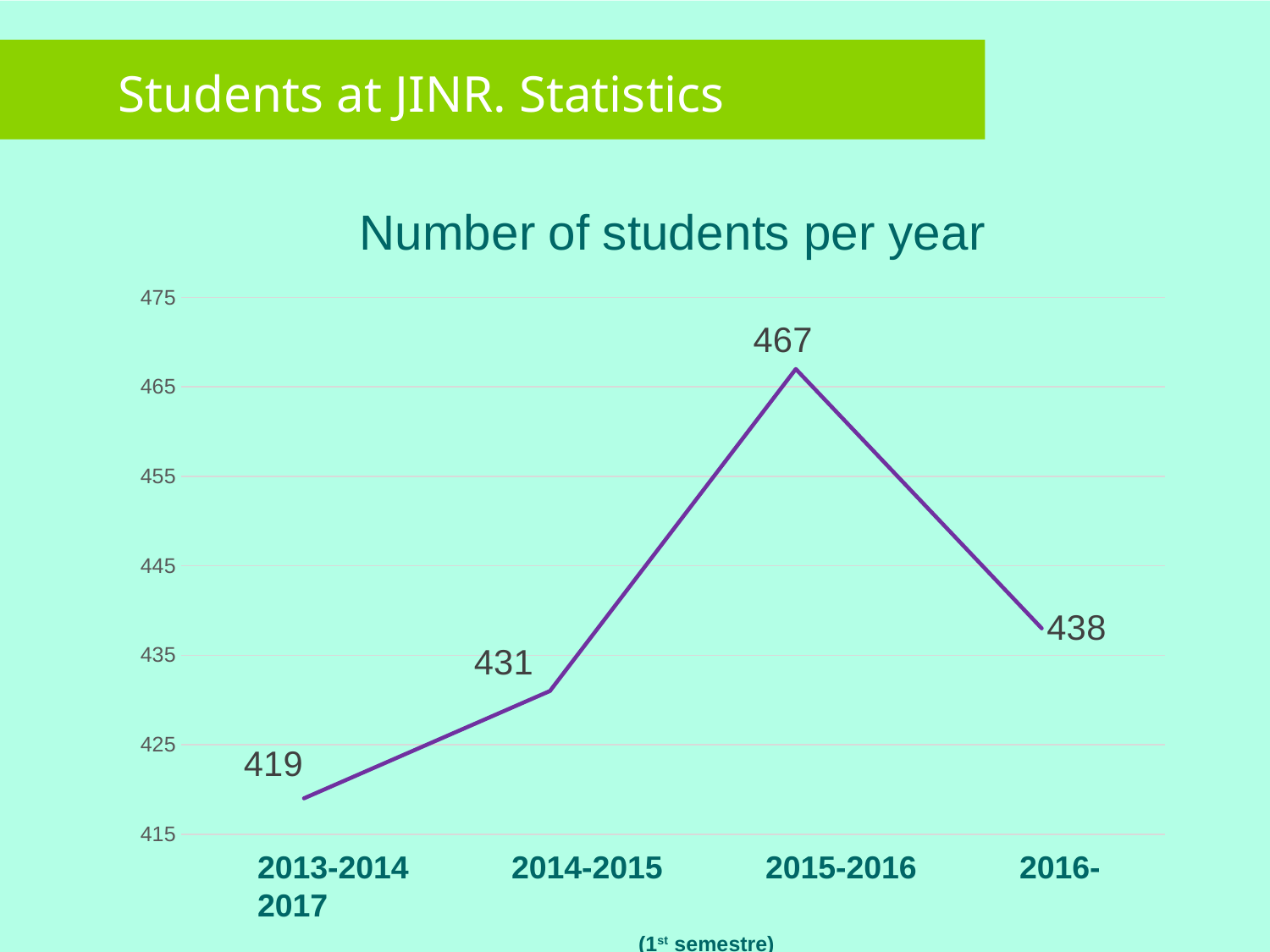
What kind of chart is shown on the slide? line chart What is the title of the chart? Number of students per year Which year has more students, 2014-2015 or 2016-2017? 2016-2017 What is the number of students for 2015-2016? 467 What is the number of students for 2013-2014? 419 Which year has the lowest number of students? 2013-2014 What is the number of students for 2016-2017 (1st semestre)? 438 How many years are plotted on the chart? 4 What is the difference in the number of students between 2016-2017 and 2013-2014? 19 Which year has the highest number of students? 2015-2016 What is the difference in the number of students between 2015-2016 and 2014-2015? 36 Is the value for 2014-2015 greater or less than 435? less